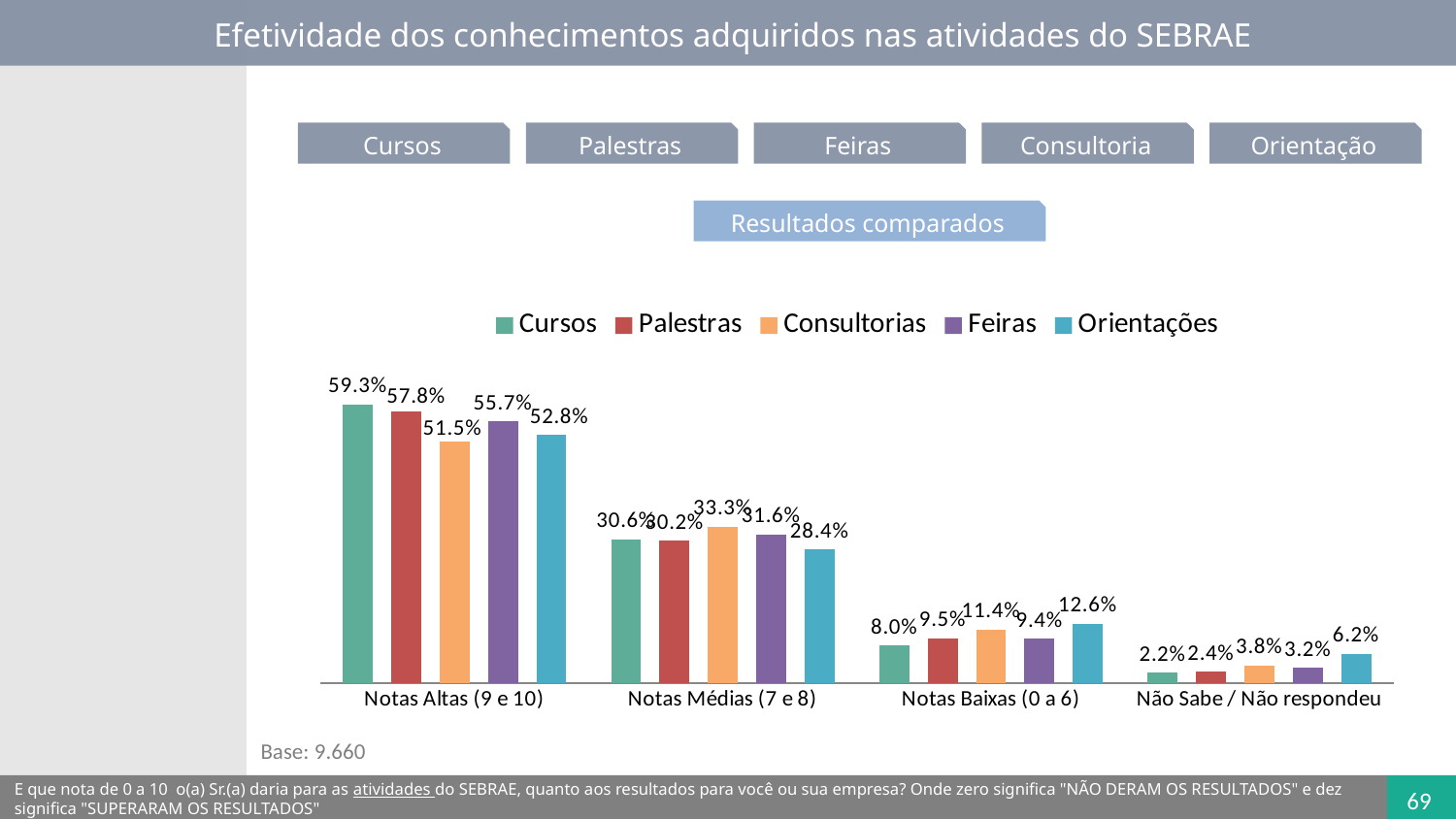
Which is larger in the Notas Baixas (0 a 6) category: Orientações or Palestras? Orientações Do the values for Feiras rise or fall moving from Notas Altas (9 e 10) to Não Sabe / Não respondeu along the x axis? Fall How many categories are shown on the x axis? 4 What kind of chart is shown on the slide? Bar chart Which series has the highest value in the Notas Altas (9 e 10) category? Cursos Which series is shown in orange in the legend? Consultorias What is the value for Consultorias in the Notas Médias (7 e 8) category? 33.3% What is the value for Cursos in the Notas Altas (9 e 10) category? 59.3% What is the difference between Cursos and Consultorias in the Notas Altas (9 e 10) category? 7.8% Which series has the lowest value in the Notas Baixas (0 a 6) category? Cursos How many series does the legend list? 5 What is the value for Orientações in the Não Sabe / Não respondeu category? 6.2%